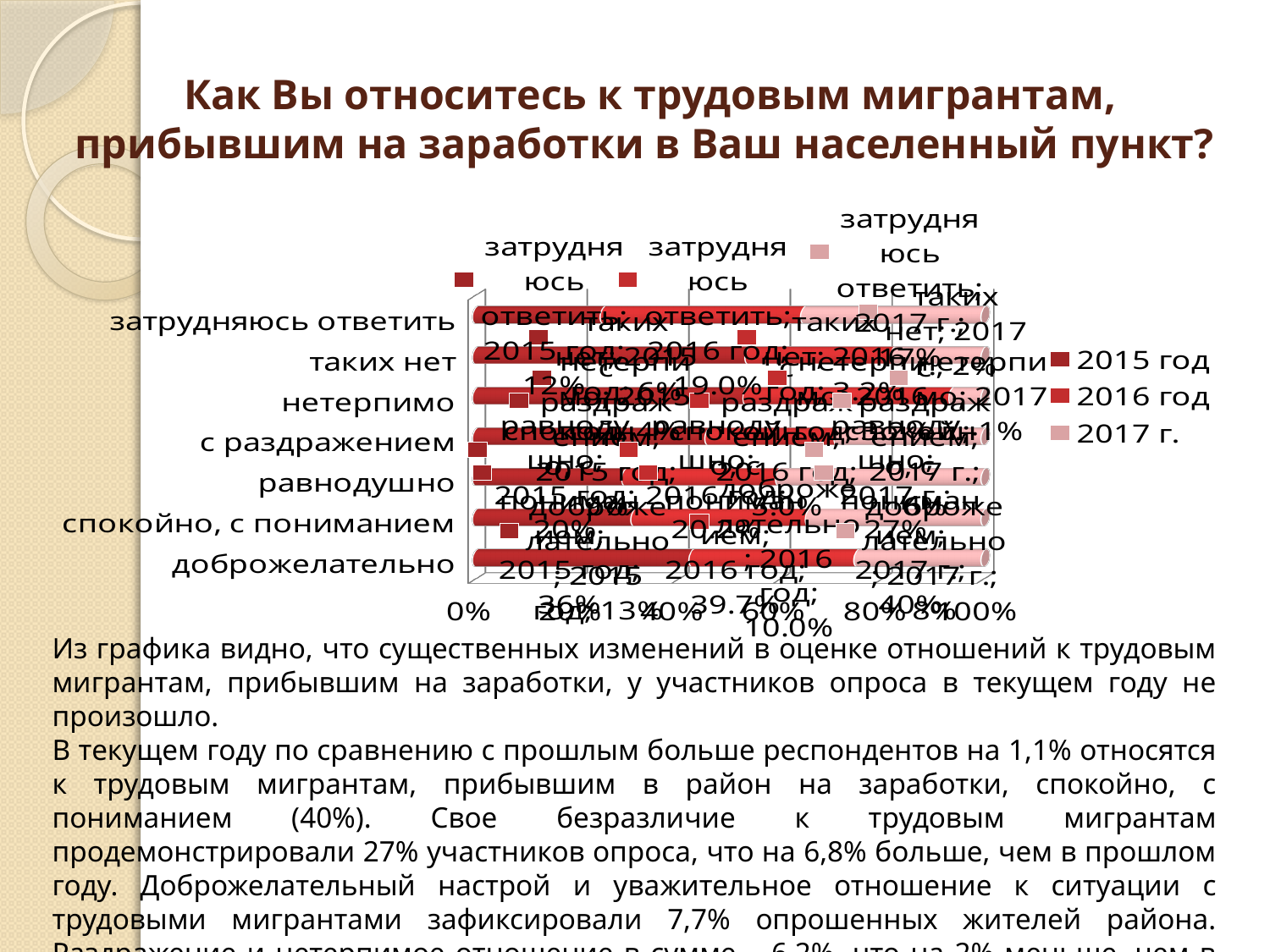
What kind of chart is shown on the slide? bar chart How many categories are listed on the vertical axis of the chart? 7 Which years are listed in the chart legend? 2015 год, 2016 год, 2017 г. What is the highest value shown on the horizontal axis of the chart? 100% Which category appears at the bottom of the vertical axis of the chart? доброжелательно How many series does the chart legend list? 3 Which category appears at the top of the vertical axis of the chart? затрудняюсь ответить